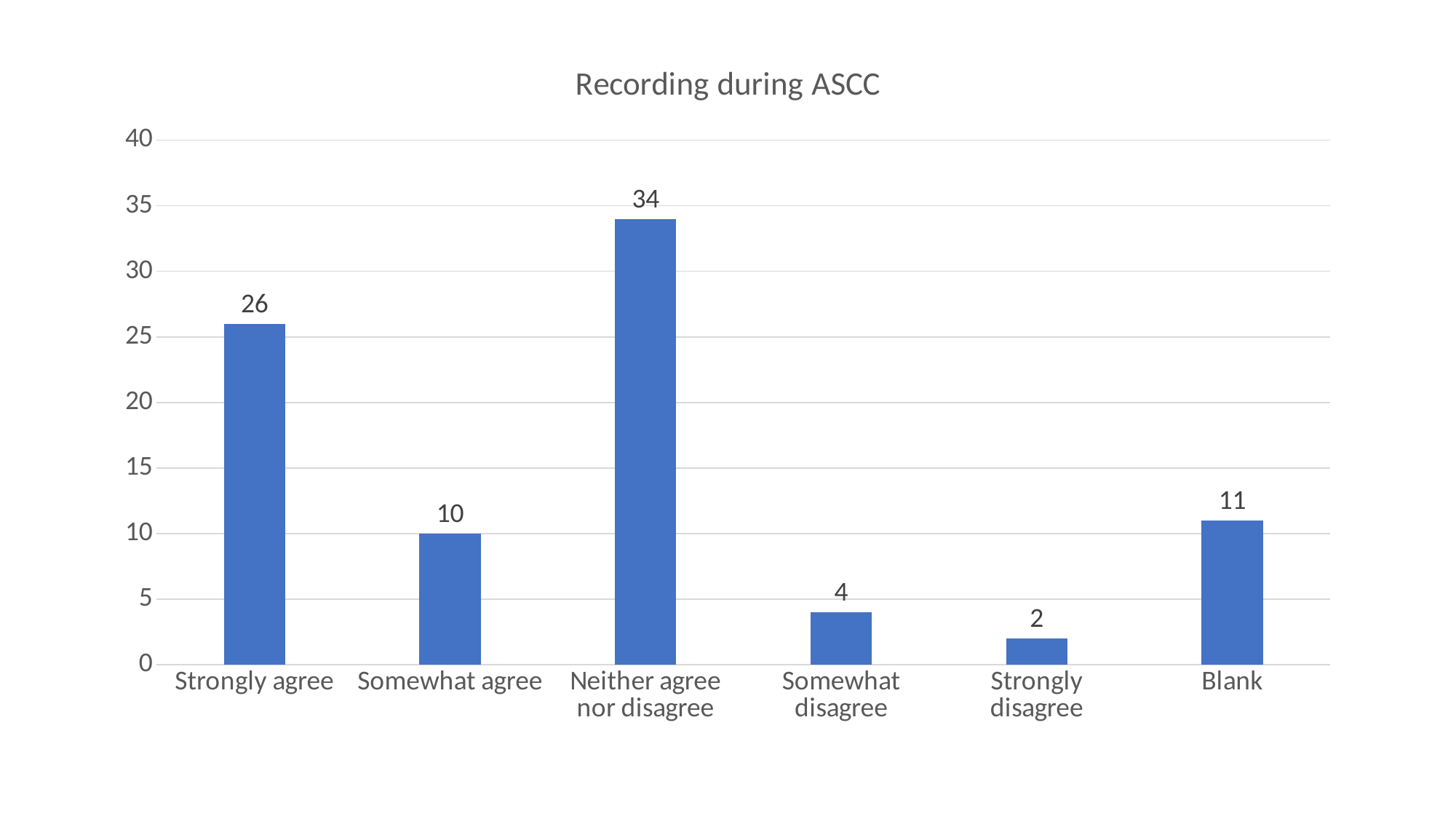
Which is larger, the value for Blank or the value for Somewhat agree? Blank What is the difference between the values for Somewhat agree and Somewhat disagree? 6 How many categories are shown on the x axis? 6 Which category has the highest value? Neither agree nor disagree Which category has the lowest value? Strongly disagree What kind of chart is this? Bar chart What is the value for Strongly agree? 26 What is the difference between the values for Neither agree nor disagree and Strongly agree? 8 What is the value for Neither agree nor disagree? 34 What is the value for Strongly disagree? 2 What is the value for Blank? 11 What is the title of the chart? Recording during ASCC